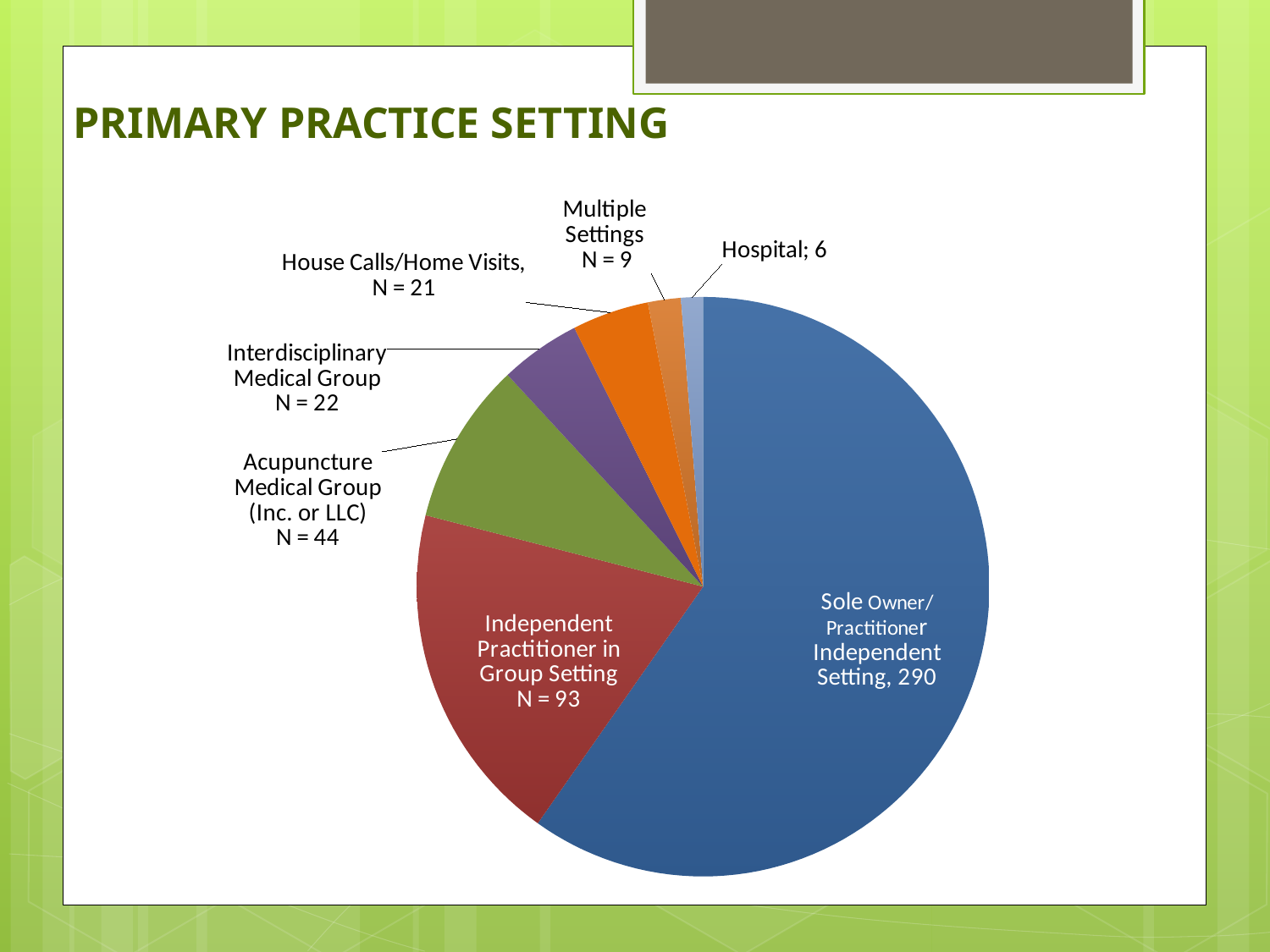
Which practice setting has the smallest slice? Hospital What is the value for Sole Owner/Practitioner Independent Setting? 290 Which practice setting has the largest slice? Sole Owner/Practitioner Independent Setting What is the total of all slices in the pie chart? 485 What is the title of the chart? PRIMARY PRACTICE SETTING What is the N value for Independent Practitioner in Group Setting? 93 Which is larger, Acupuncture Medical Group (Inc. or LLC) or Multiple Settings? Acupuncture Medical Group (Inc. or LLC) What is the difference between Sole Owner/Practitioner Independent Setting and Independent Practitioner in Group Setting? 197 What is the value for Hospital? 6 How many slices does the pie chart have? 7 What is the N value for Acupuncture Medical Group (Inc. or LLC)? 44 What type of chart is shown on the slide? Pie chart